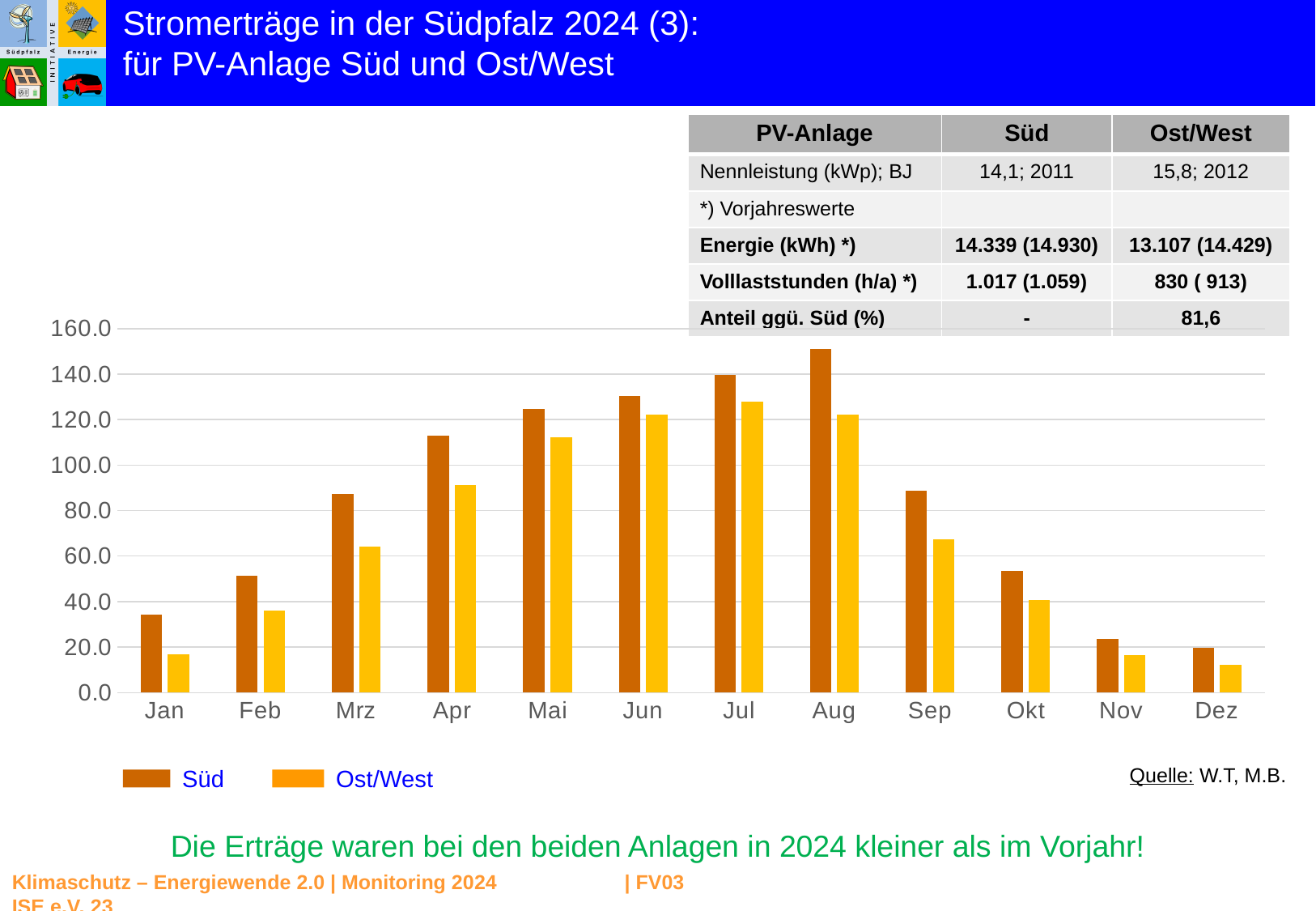
Which colour represents the Ost/West series in the chart? yellow/orange In which month is the Süd value highest? Aug In Aug, which series has the larger value, Süd or Ost/West? Süd How many series does the chart legend list? 2 What kind of chart is shown on the slide? bar chart Is the Ost/West value for Jan greater or less than 20? less Do the Süd values rise or fall from Aug to Dez? fall In which month is the Ost/West value lowest? Dez How many months are shown on the x axis of the chart? 12 In which month is the Süd value lowest? Dez In which month is the Ost/West value highest? Jul Is the Süd value for Aug greater or less than 140? greater